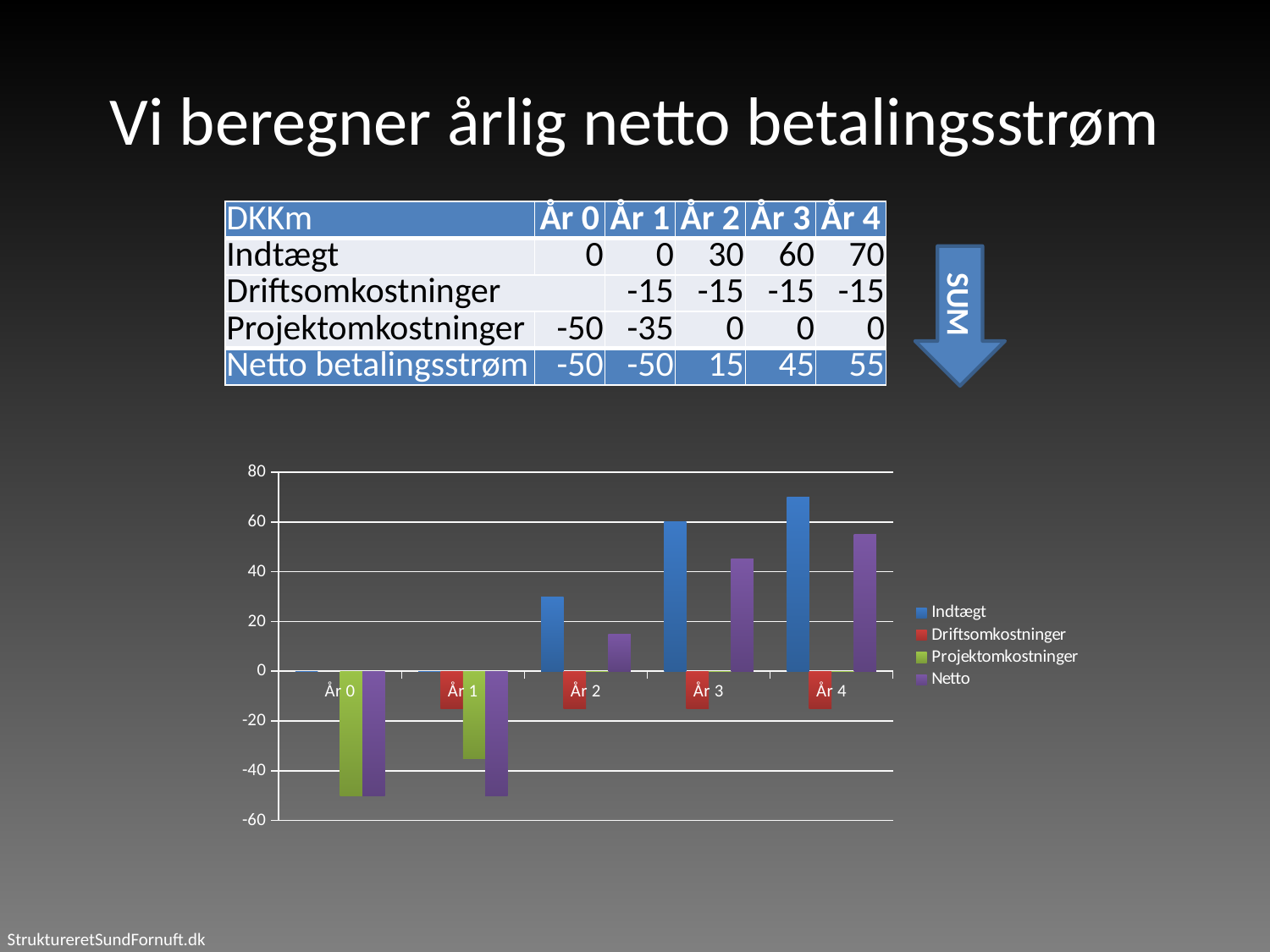
How many year categories are plotted along the x axis of the chart? 5 How many series does the chart legend list? 4 Is the value of Indtægt for År 4 greater or less than 60? greater For År 3, which is larger: Indtægt or Netto? Indtægt Does Indtægt rise or fall from År 0 to År 4? rise What is the value of Netto for År 4? 55 In which year is Projektomkostninger lowest? År 0 What is the difference between Indtægt and Netto for År 4? 15 What kind of chart is shown on the slide? bar chart In which year is Indtægt highest? År 4 Is the value of Netto for År 3 greater or less than 40? greater What is the value of Indtægt for År 3? 60